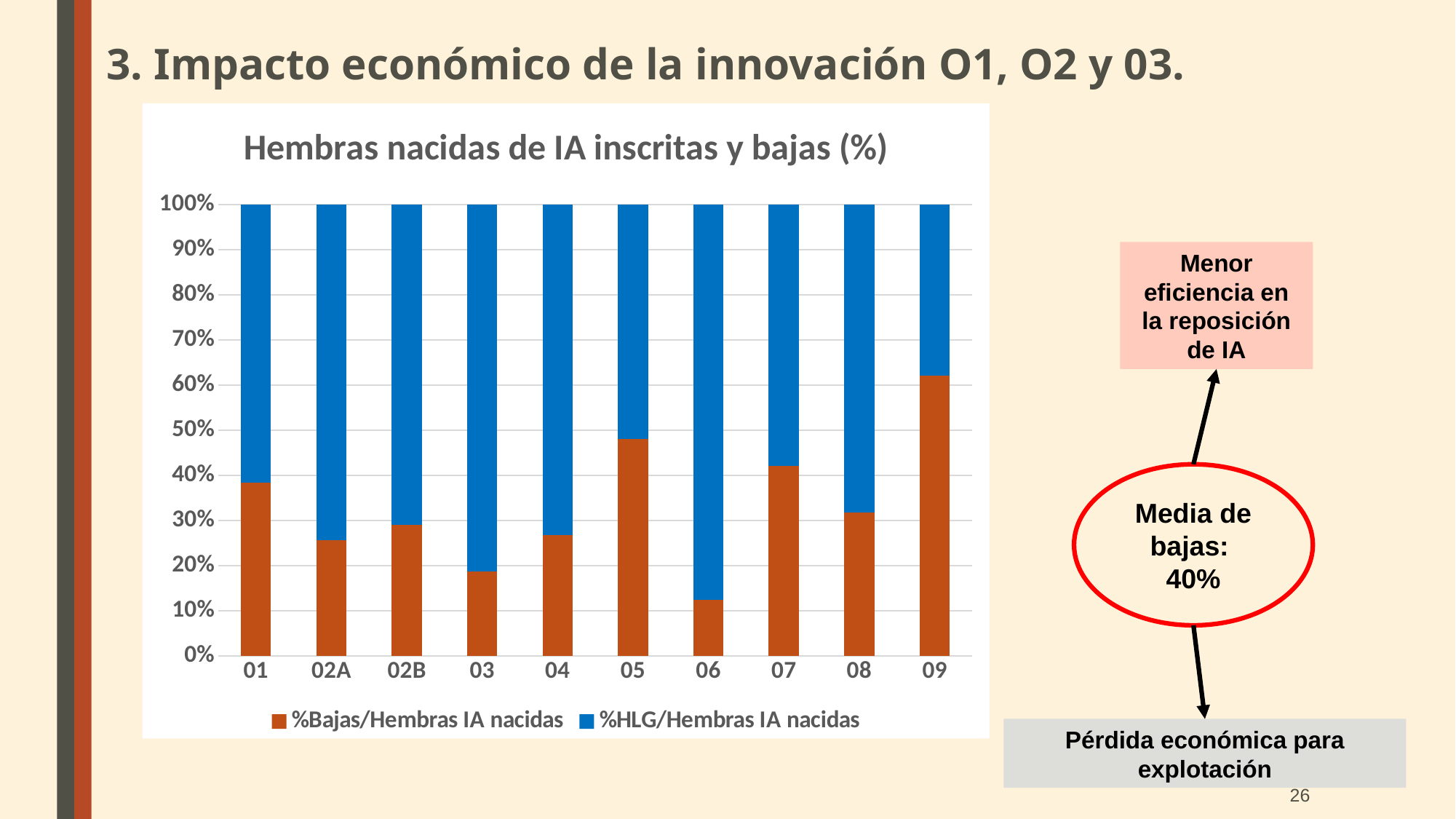
Which category has the highest value for %HLG/Hembras IA nacidas? 06 Is the value for %Bajas/Hembras IA nacidas in category 09 greater or less than 50%? greater How many categories are shown on the x axis of the chart? 10 Which is larger, the %Bajas/Hembras IA nacidas value for 07 or for 08? 07 What is the title of the chart? Hembras nacidas de IA inscritas y bajas (%) Is the value for %Bajas/Hembras IA nacidas in category 05 greater or less than 40%? greater What kind of chart is shown on the slide? bar chart Which category has the highest value for %Bajas/Hembras IA nacidas? 09 How many series does the chart legend list? 2 Which category has the lowest value for %Bajas/Hembras IA nacidas? 06 What is the total of the stacked bar for category 01? 100% Is the value for %Bajas/Hembras IA nacidas in category 03 greater or less than 20%? less